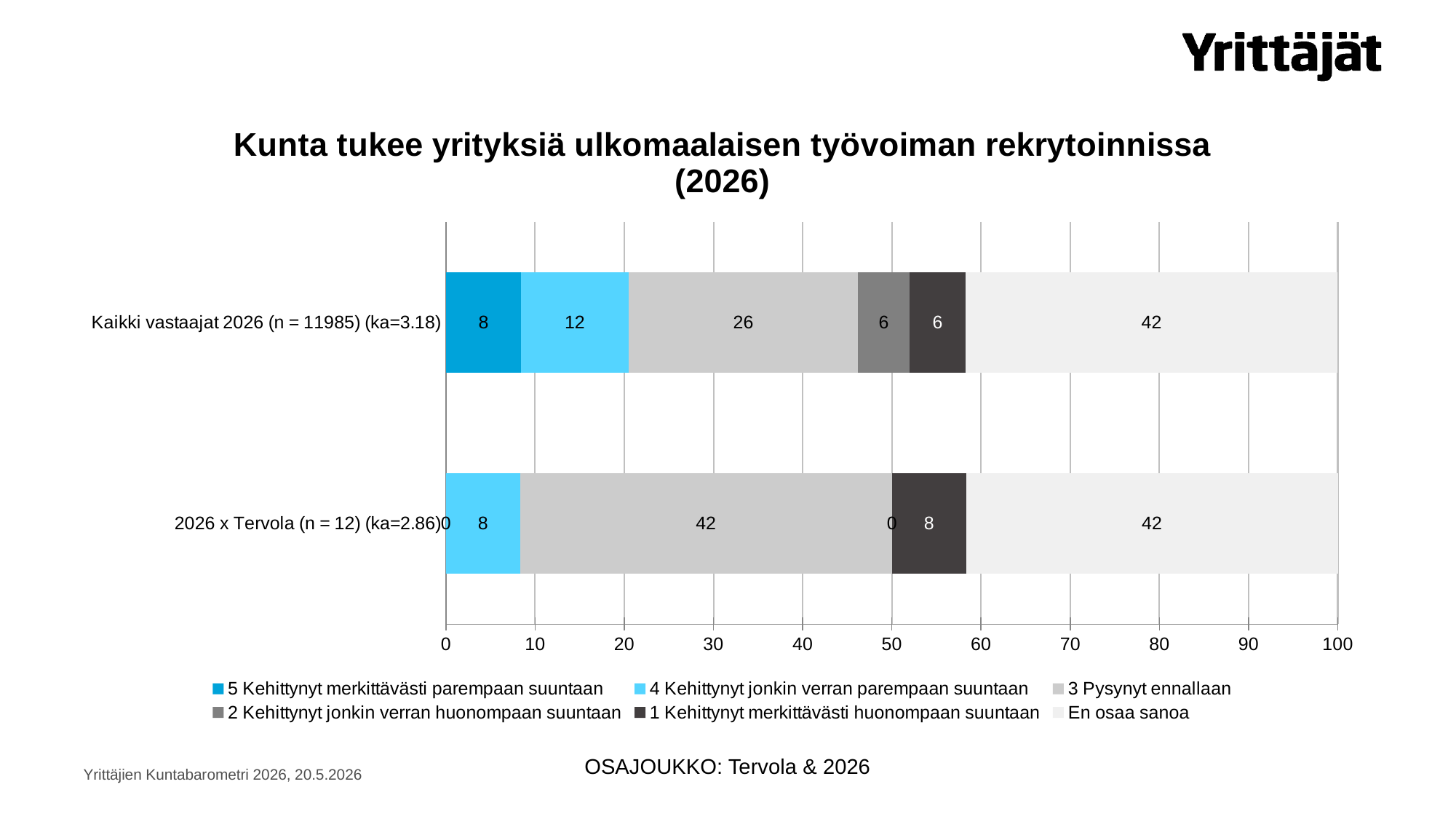
What is the value of '5 Kehittynyt merkittävästi parempaan suuntaan' for '2026 x Tervola (n = 12) (ka=2.86)'? 0 How many series does the legend list? 6 What is the value of 'En osaa sanoa' for '2026 x Tervola (n = 12) (ka=2.86)'? 42 What is the difference between the '3 Pysynyt ennallaan' values for '2026 x Tervola (n = 12) (ka=2.86)' and 'Kaikki vastaajat 2026 (n = 11985) (ka=3.18)'? 16 What is the value of '3 Pysynyt ennallaan' for 'Kaikki vastaajat 2026 (n = 11985) (ka=3.18)'? 26 What is the value of '1 Kehittynyt merkittävästi huonompaan suuntaan' for '2026 x Tervola (n = 12) (ka=2.86)'? 8 What kind of chart is shown on the slide? Stacked bar chart What is the value of '4 Kehittynyt jonkin verran parempaan suuntaan' for 'Kaikki vastaajat 2026 (n = 11985) (ka=3.18)'? 12 What is the total of the stacked bar for 'Kaikki vastaajat 2026 (n = 11985) (ka=3.18)'? 100 What is the title of the chart? Kunta tukee yrityksiä ulkomaalaisen työvoiman rekrytoinnissa (2026) How many categories (bars) does the chart show? 2 Which category has the larger value for '4 Kehittynyt jonkin verran parempaan suuntaan'? Kaikki vastaajat 2026 (n = 11985) (ka=3.18)